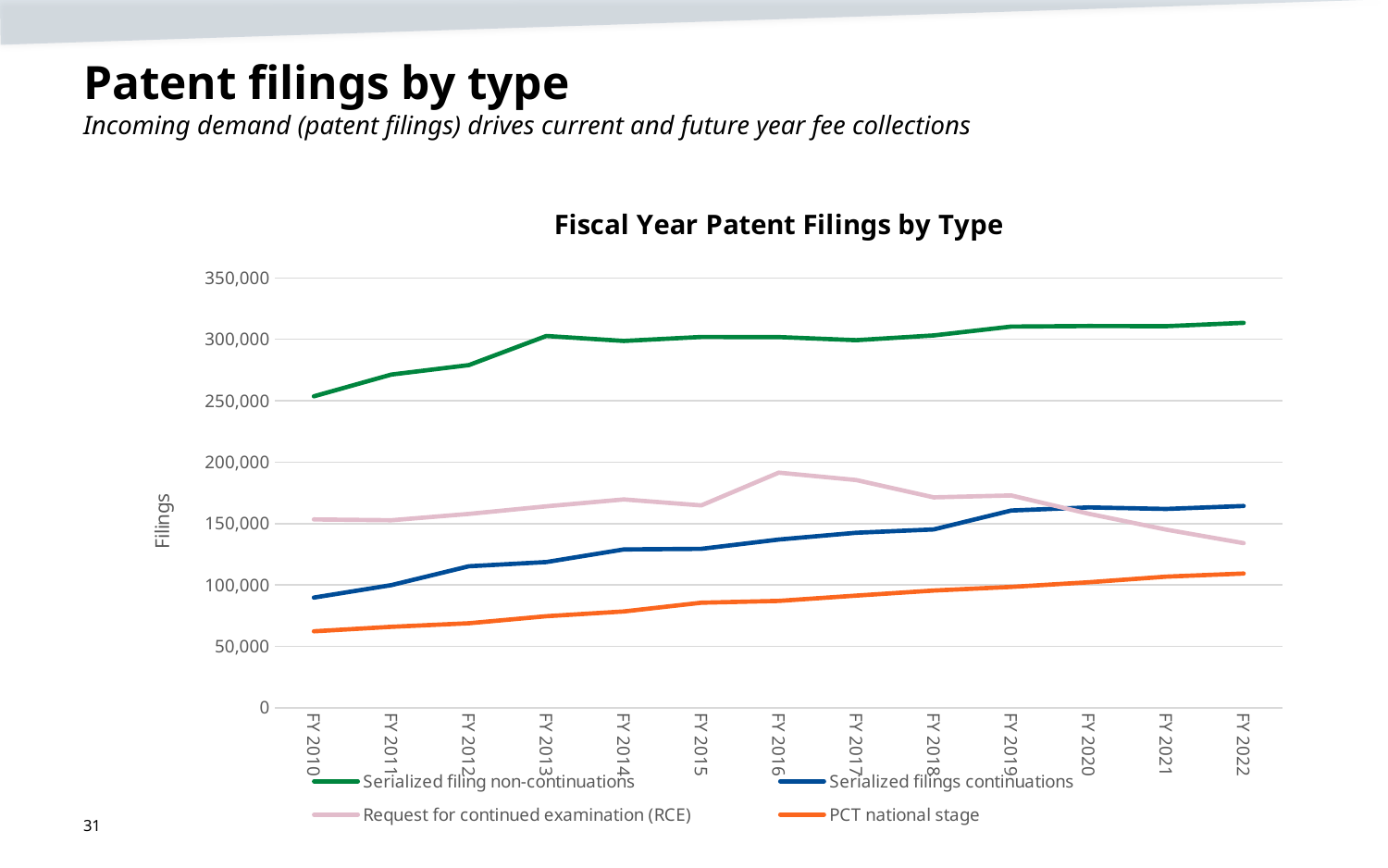
How many fiscal years are plotted along the x axis? 13 Is the value for PCT national stage in FY 2010 greater or less than 100,000? less In FY 2022, which is larger: Serialized filings continuations or Request for continued examination (RCE)? Serialized filings continuations Which series has the highest value in FY 2022? Serialized filing non-continuations In FY 2016, which is larger: Request for continued examination (RCE) or Serialized filings continuations? Request for continued examination (RCE) How many series does the legend list? 4 What kind of chart is shown on the slide? Line chart Is the value for Request for continued examination (RCE) in FY 2016 greater or less than 150,000? greater Which series has the lowest value in FY 2010? PCT national stage Does the PCT national stage series rise or fall from FY 2010 to FY 2022? Rise What is the title of the chart? Fiscal Year Patent Filings by Type Is the value for Serialized filing non-continuations in FY 2022 greater or less than 300,000? greater